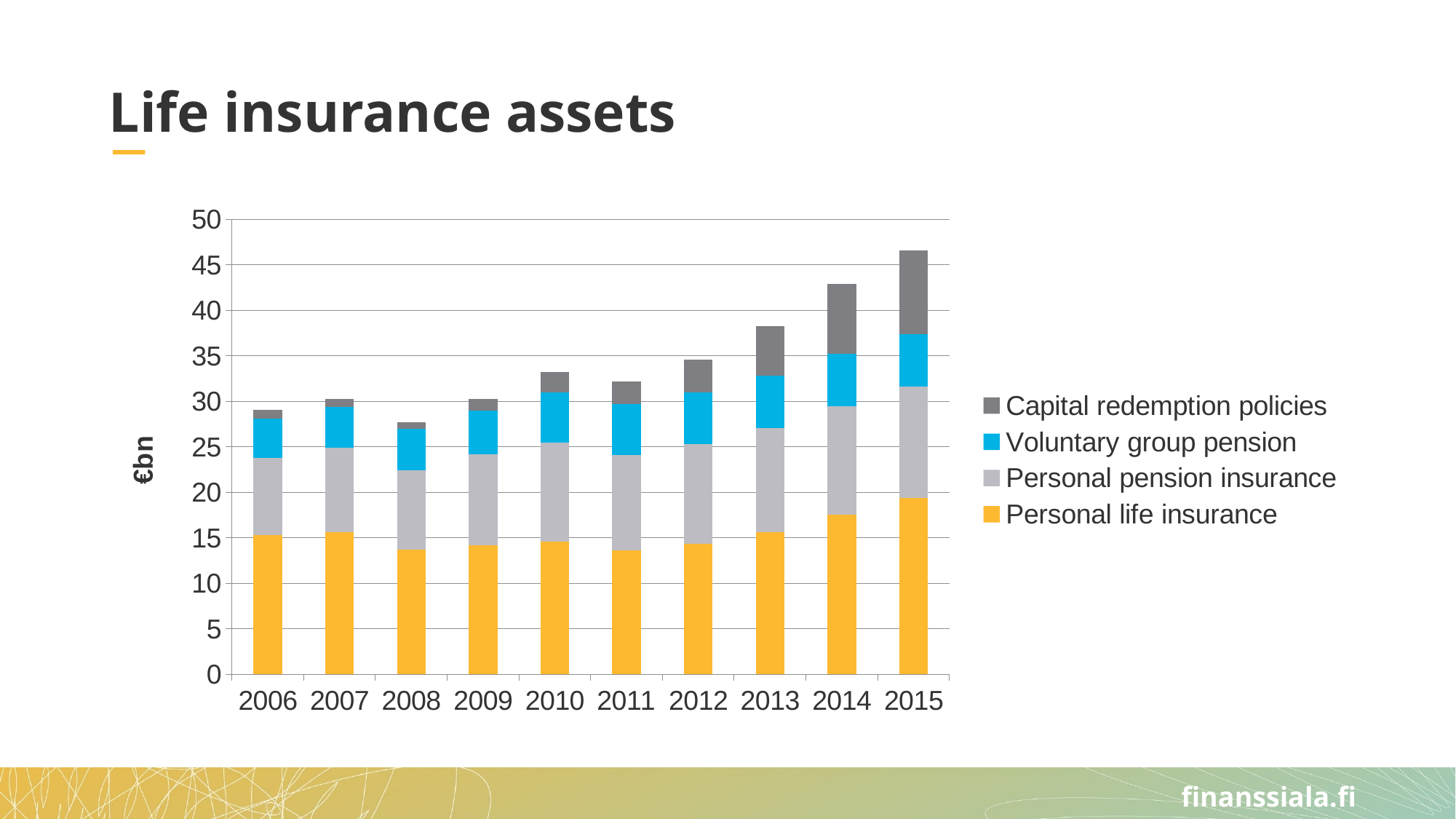
What kind of chart is shown on the slide? Stacked bar chart Is the Personal life insurance value for 2014 greater or less than 15? greater Is the total for 2015 greater or less than 45? greater Which year has the lowest total life insurance assets? 2008 Is the total for 2013 greater or less than 35? greater What unit is shown on the y axis label? €bn Which year has the larger total, 2013 or 2014? 2014 How many series does the legend list? 4 How many years are shown on the x axis? 10 Which year has the highest total life insurance assets? 2015 Do total life insurance assets generally rise or fall from 2006 to 2015? Rise